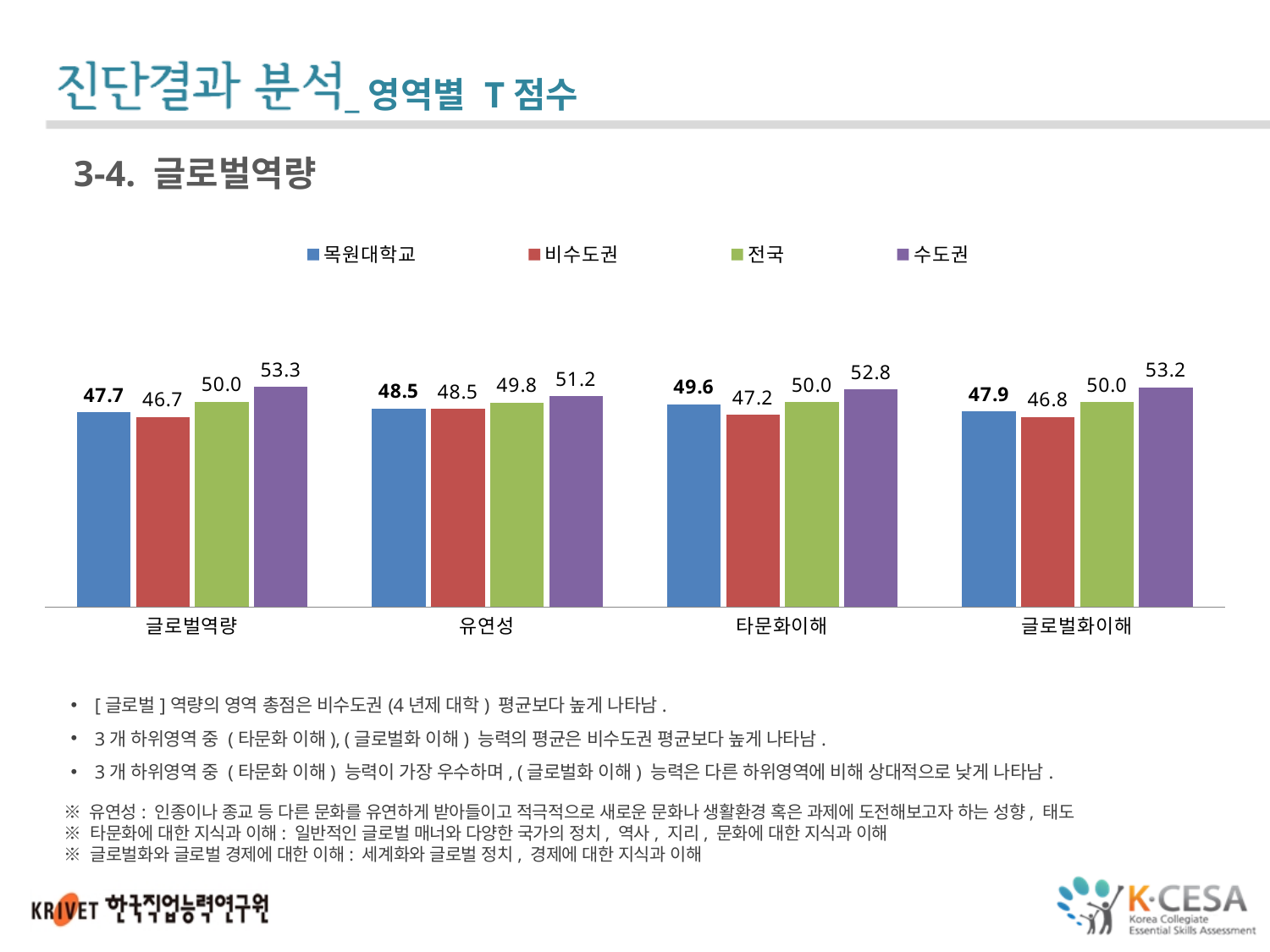
Which series has the lowest value in the 타문화이해 category? 비수도권 Which is larger in the 타문화이해 category: the value for 목원대학교 or the value for 비수도권? 목원대학교 What kind of chart is shown on the slide? Bar chart Which series has the highest value in the 글로벌역량 category? 수도권 What is the value for 전국 in the 유연성 category? 49.8 What is the value for 수도권 in the 타문화이해 category? 52.8 What is the value for 목원대학교 in the 글로벌역량 category? 47.7 How many series does the legend list? 4 What is the value for 비수도권 in the 글로벌화이해 category? 46.8 Which colour represents the 전국 series in the legend? Green How many categories are shown on the x axis? 4 What is the difference between the 수도권 and 목원대학교 values in the 글로벌화이해 category? 5.3